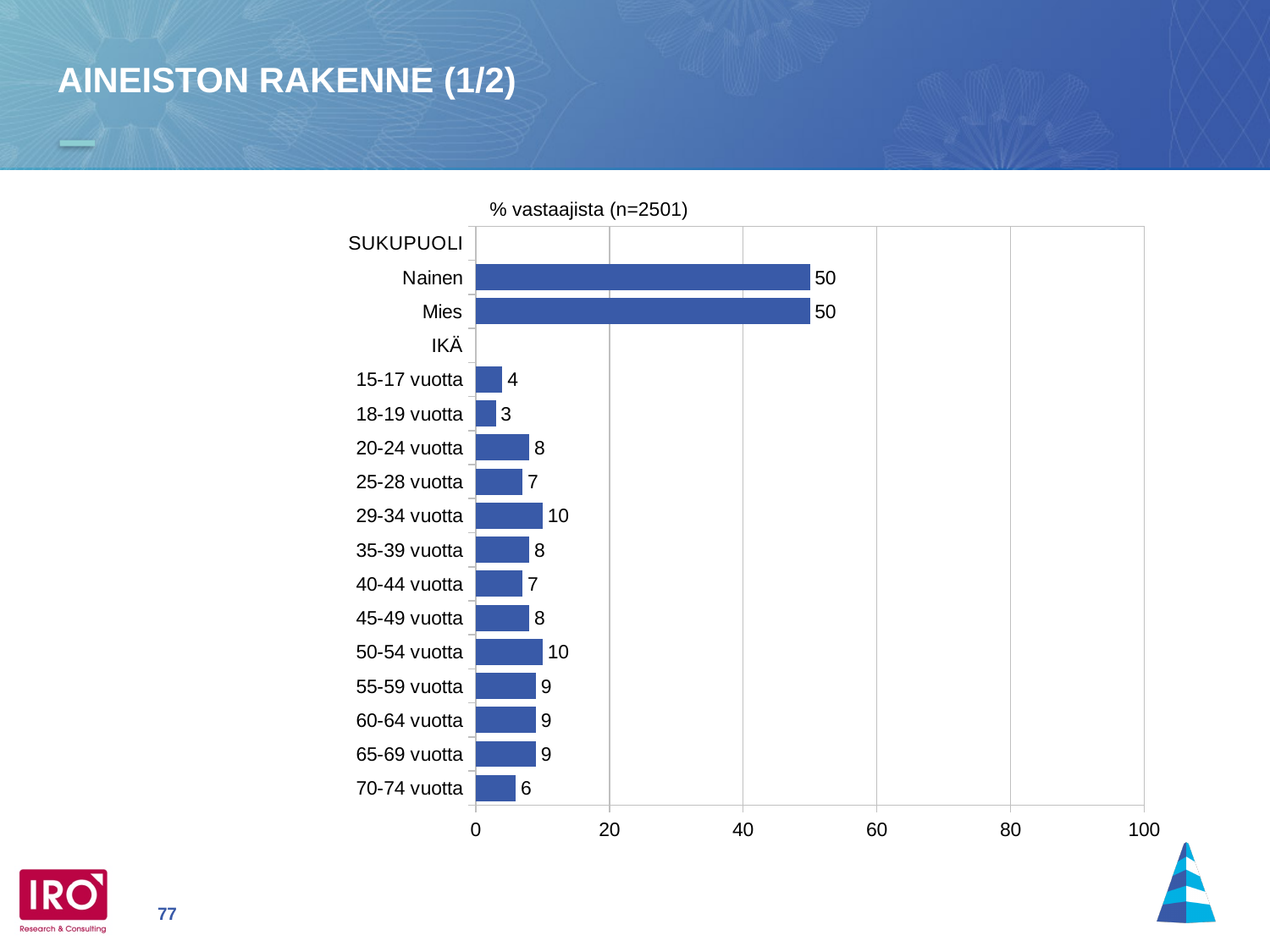
What is the value for 70-74 vuotta? 6 Is the value for Mies greater or less than 40? greater What is the title of the chart? % vastaajista (n=2501) What is the value for Nainen? 50 What is the highest value shown on the x axis? 100 What is the value for 29-34 vuotta? 10 How many age groups are shown under IKÄ? 13 What is the value for 18-19 vuotta? 3 Which is larger, the value for 20-24 vuotta or the value for 25-28 vuotta? 20-24 vuotta Which age group has the lowest value? 18-19 vuotta What kind of chart is shown on the slide? bar chart What is the difference between the values for 50-54 vuotta and 15-17 vuotta? 6